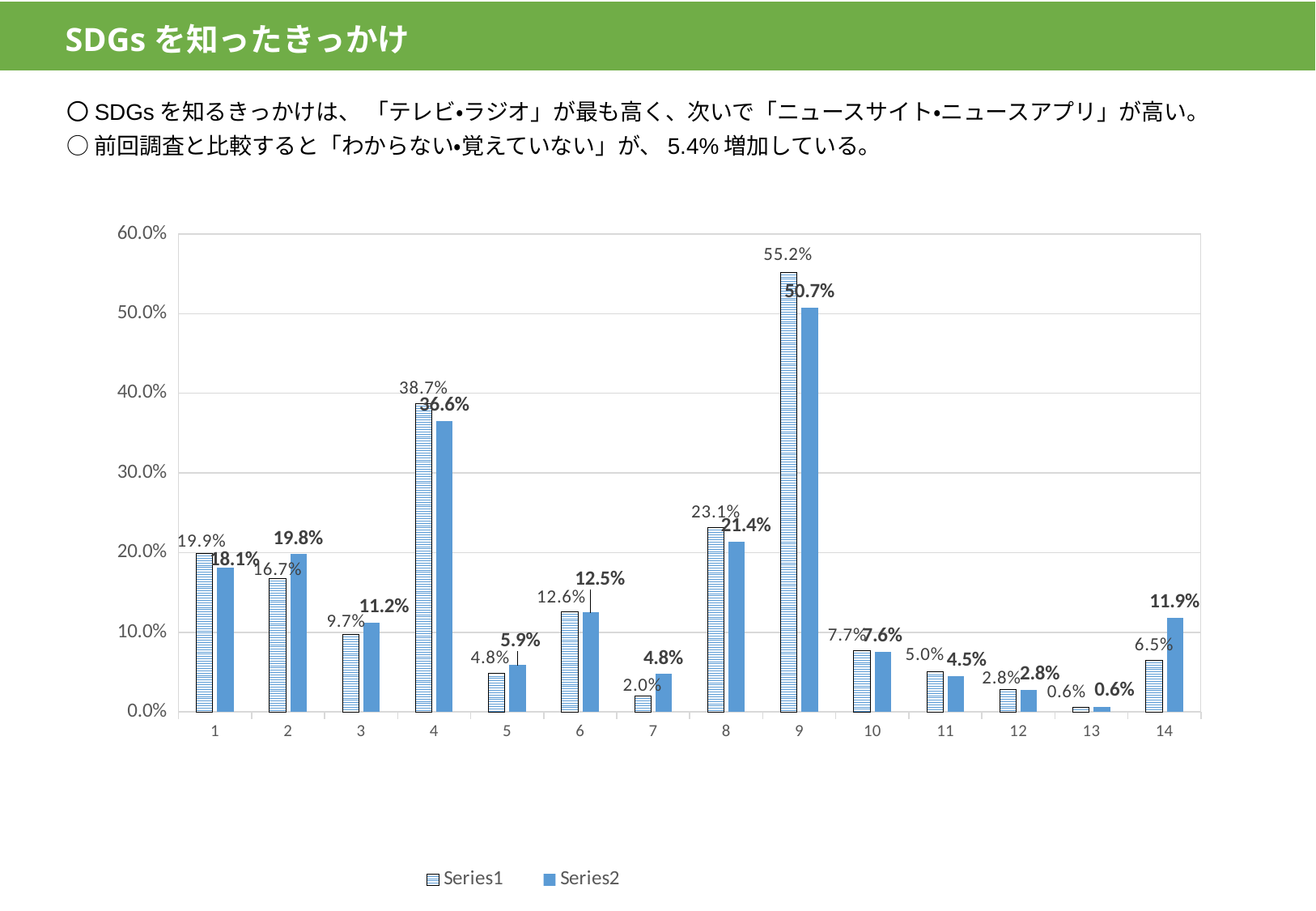
What is the difference between the Series2 and Series1 values for category 14? 5.4% For category 2, which is larger, Series1 or Series2? Series2 Is the Series1 value for category 8 greater or less than 20.0%? greater What is the difference between the Series1 and Series2 values for category 9? 4.5% What is the Series1 value for category 4? 38.7% Which category has the lowest Series1 value? 13 What is the Series1 value for category 9? 55.2% How many series does the legend list? 2 What kind of chart is shown on the slide? Bar chart What is the Series2 value for category 14? 11.9% How many categories are shown on the x axis? 14 Which category has the highest Series2 value? 9